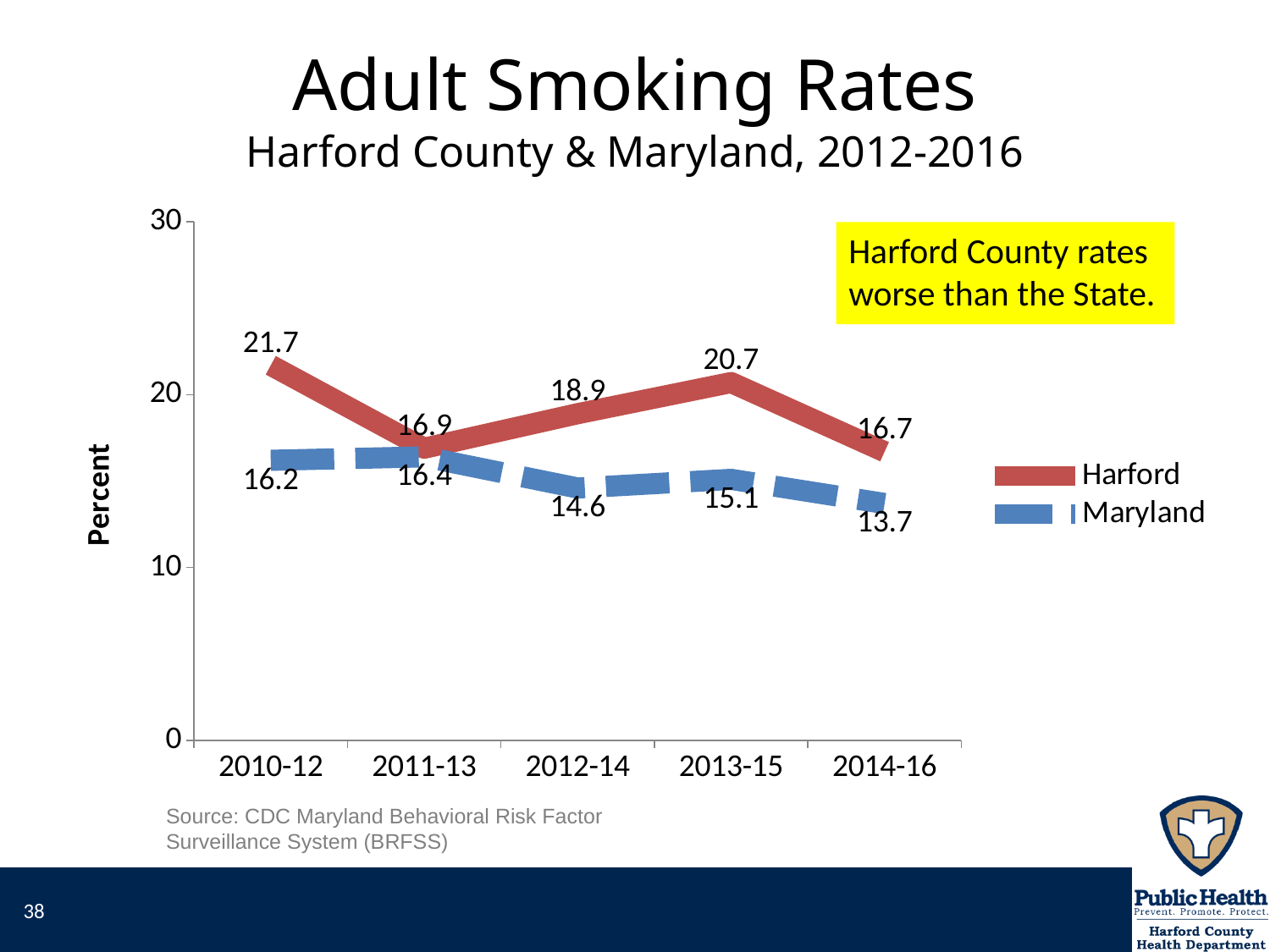
What is the Maryland adult smoking rate for 2014-16? 13.7 In which period is the Harford rate highest? 2010-12 What is the difference between the Harford and Maryland rates in 2013-15? 5.6 What kind of chart is shown on the slide? line chart How many series does the legend list? 2 How many time periods are shown on the x axis? 5 In which period is the Maryland rate lowest? 2014-16 Which is larger in 2012-14, the Harford rate or the Maryland rate? Harford What is the label on the y axis? Percent What is the Harford value for 2013-15? 20.7 What is the Harford adult smoking rate for 2010-12? 21.7 Is the Harford value for 2010-12 greater or less than 20? greater